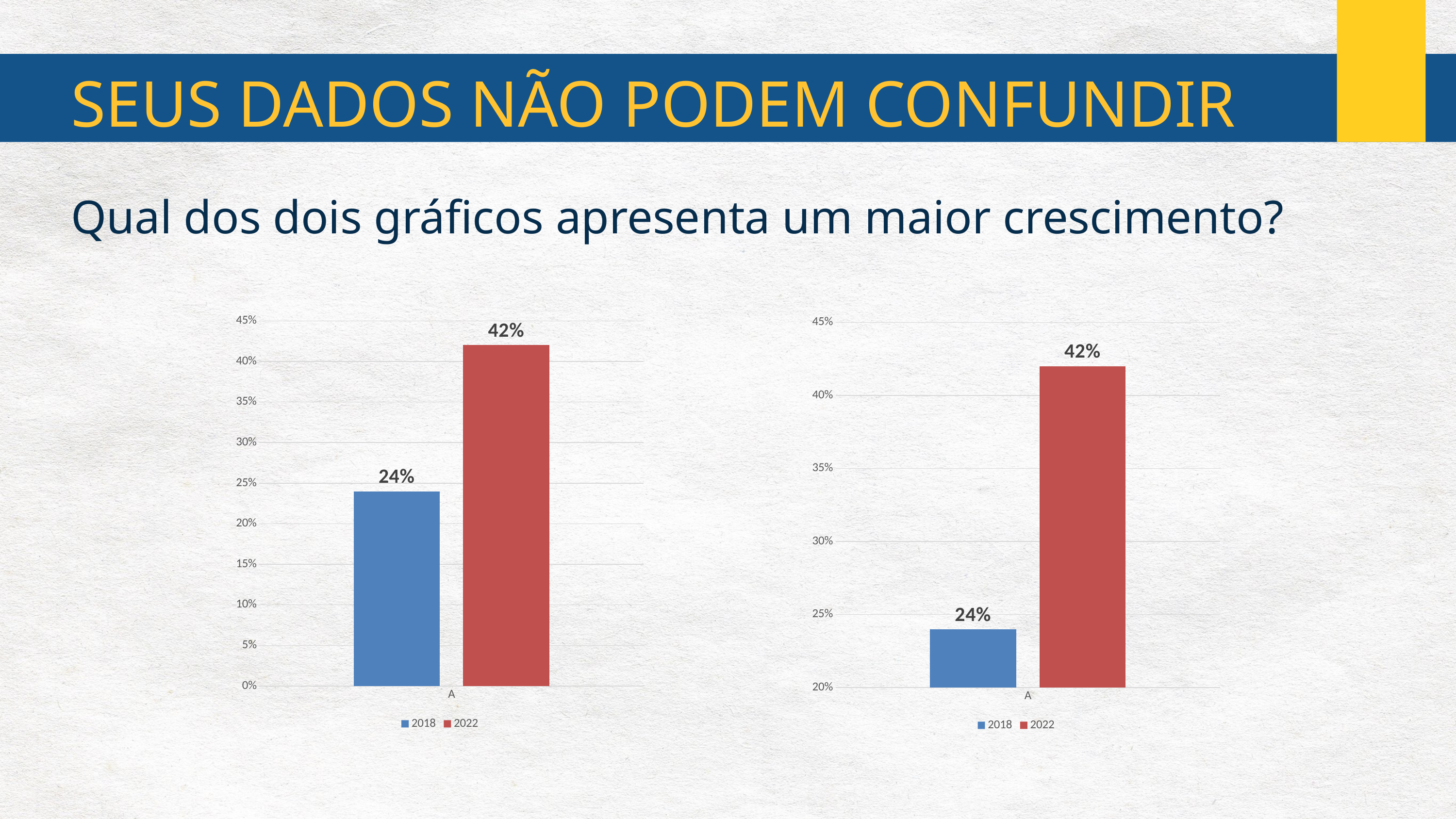
In the left chart, what is the lowest value shown on the vertical axis? 0% In the left chart, what is the value for 2018? 24% In the right chart, what is the difference between the 2022 and 2018 values? 18% In the left chart, what is the value for 2022? 42% In the right chart, what is the lowest value shown on the vertical axis? 20% In the left chart, what is the difference between the 2022 and 2018 values? 18% In the left chart, which series has the higher value, 2018 or 2022? 2022 In the right chart, is the value for 2018 greater or less than 25%? less How many series does the legend of the left chart list? 2 In the right chart, what is the value for 2018? 24% What kind of chart is the right chart? Bar chart In the right chart, what is the value for 2022? 42%